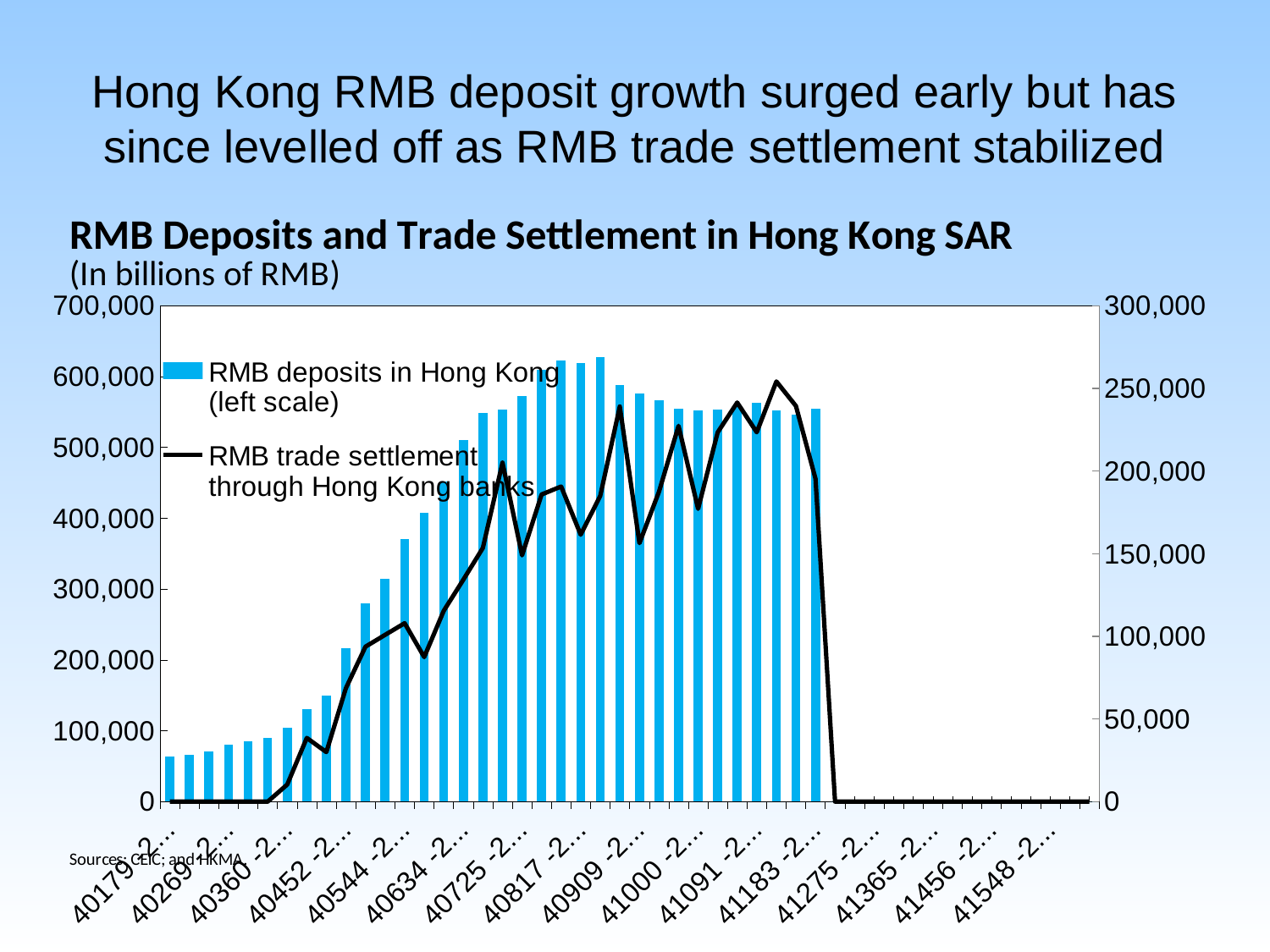
How many series does the legend list? 2 Do the RMB deposits bars rise or fall from the first bar up to the tallest bar? rise Is the value of the tallest RMB deposits bar greater or less than 600,000? greater Is the peak of the RMB trade settlement line greater or less than 200,000 on the right scale? greater Is the peak of the RMB trade settlement line greater or less than 300,000 on the right scale? less Which series is plotted as bars on the left scale? RMB deposits in Hong Kong What is the title of the chart? RMB Deposits and Trade Settlement in Hong Kong SAR After reaching its peak, do the RMB deposits bars rise or fall toward the last plotted bar? fall What kind of chart is shown on the slide? A combined bar and line chart